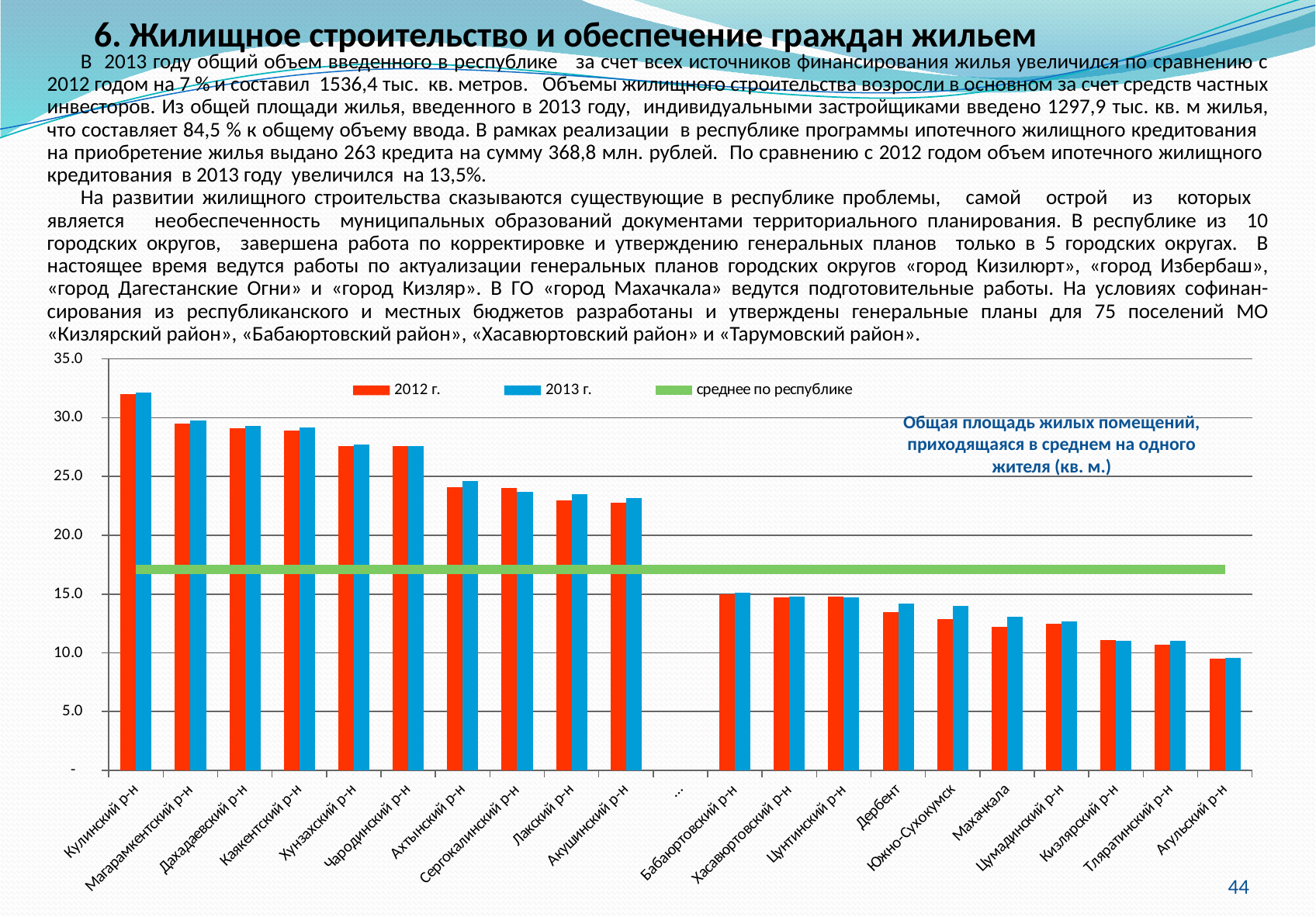
Is the 2012 г. value for Дербент greater or less than 15.0? less Which category has the larger value: Кулинский р-н or Бабаюртовский р-н? Кулинский р-н Which category has the highest value in the chart? Кулинский р-н Do the bar values generally rise or fall from left to right along the x axis? fall What is the title of the chart? Общая площадь жилых помещений, приходящаяся в среднем на одного жителя (кв. м.) Which is larger for Махачкала: the 2012 г. value or the 2013 г. value? 2013 г. Is the 2013 г. value for Кулинский р-н greater or less than 30.0? greater Is the 2013 г. value for Агульский р-н greater or less than 10.0? less Which category has the lowest value in the chart? Агульский р-н How many series does the chart legend list? 3 What kind of chart is shown on the slide? combination bar and line chart